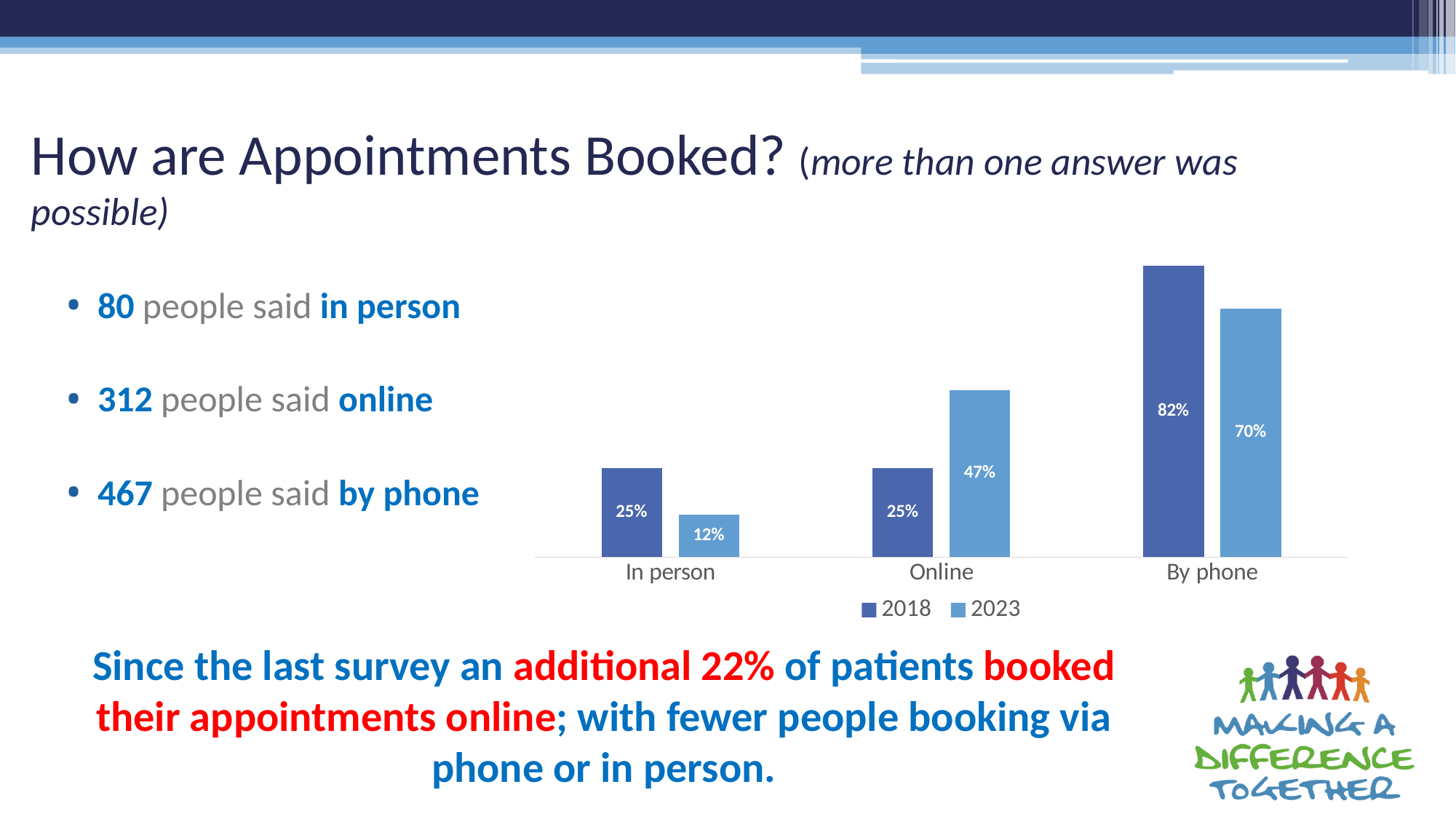
What is the difference between the 2018 and 2023 values for Online? 22% How many series does the legend list? 2 What is the difference between the 2018 and 2023 values for By phone? 12% Which category has the lowest 2023 value? In person Which category has the highest 2018 value? By phone What kind of chart is shown on the slide? Bar chart What is the 2018 value for In person? 25% What is the 2018 value for By phone? 82% What is the 2023 value for Online? 47% Which is larger for In person, the 2018 value or the 2023 value? 2018 How many categories are shown on the x axis? 3 What is the 2023 value for By phone? 70%